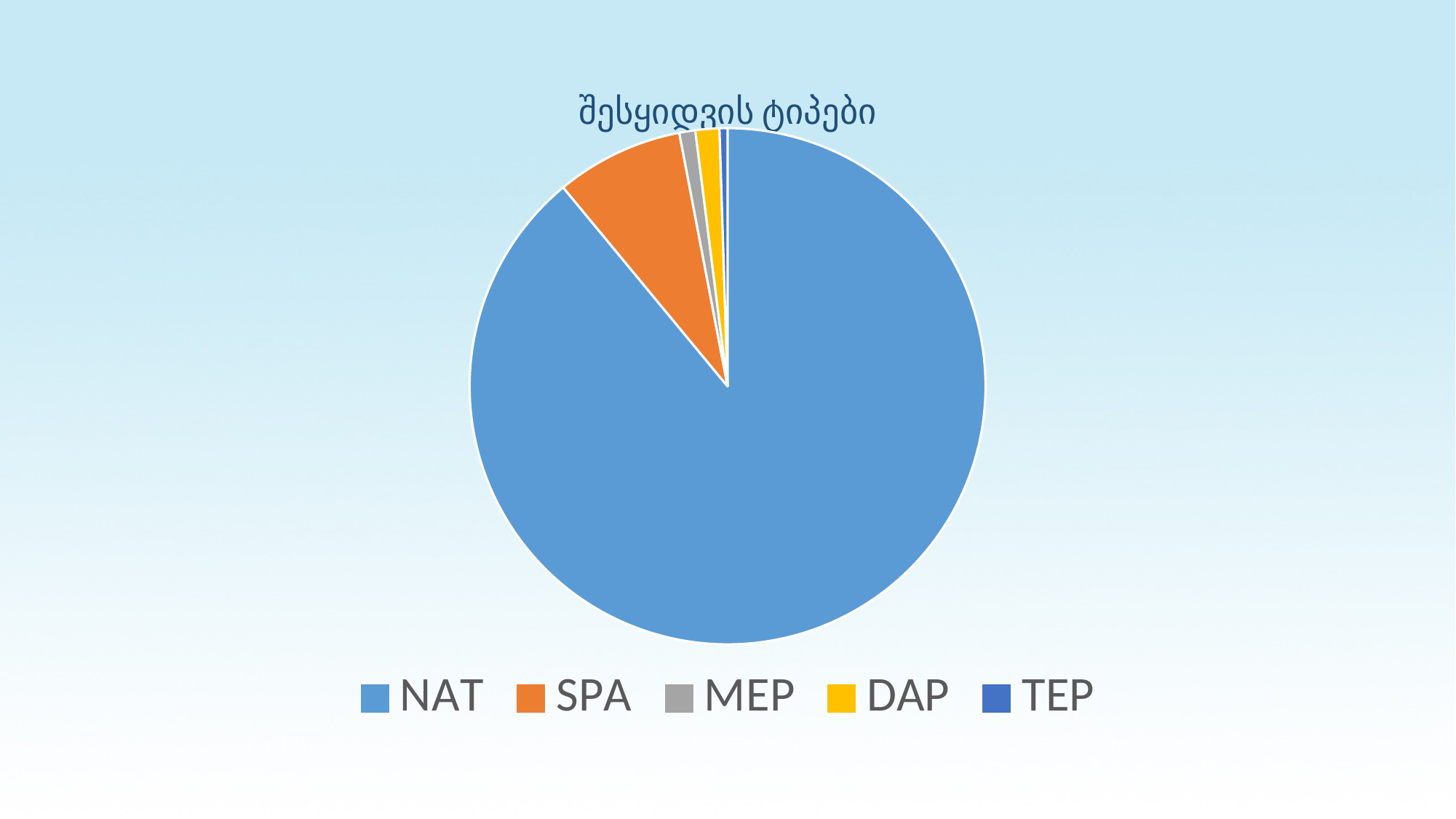
Which slice is larger, NAT or SPA? NAT How many slices does the pie chart have? 5 Which slice is larger, SPA or TEP? SPA Which category has the largest slice of the pie? NAT What is the title of the chart? შესყიდვის ტიპები Which slice is larger, SPA or MEP? SPA Which category is shown in orange in the legend? SPA Which category is the second-largest slice of the pie? SPA What kind of chart is shown on the slide? pie chart How many categories does the legend list? 5 Which category has the smallest slice of the pie? TEP